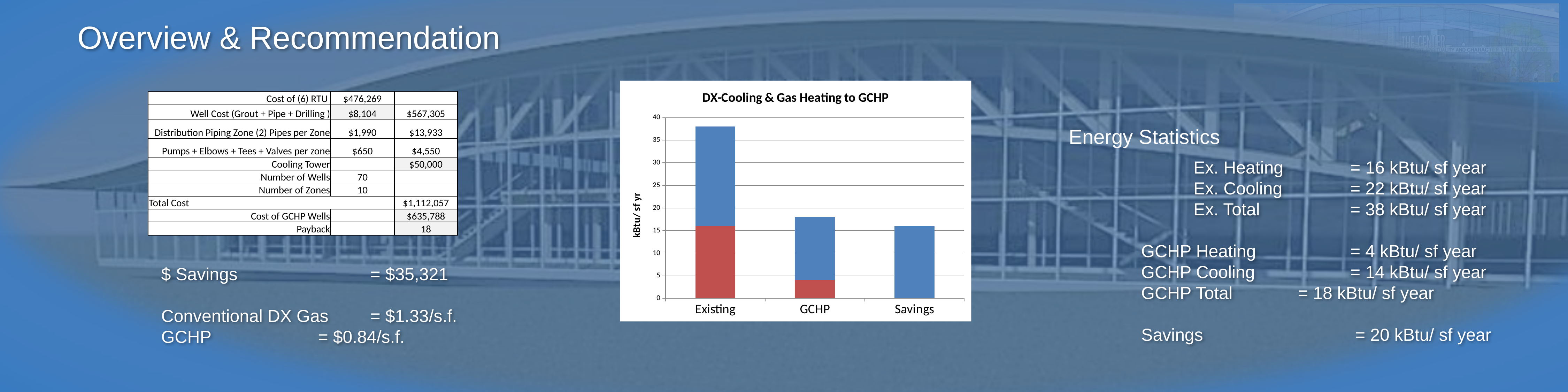
What kind of chart is shown on the slide? bar chart Which category has the tallest bar in the chart? Existing What is the title of the chart? DX-Cooling & Gas Heating to GCHP Which bar is taller, GCHP or Savings? GCHP Is the red segment of the Existing bar greater or less than 10? greater Do the bar heights rise or fall moving from Existing to Savings along the x axis? fall Is the total value of the GCHP bar greater or less than 20? less Is the total value of the Existing bar greater or less than 35? greater How many categories are shown on the x axis of the chart? 3 What is the label on the vertical axis of the chart? kBtu/ sf yr